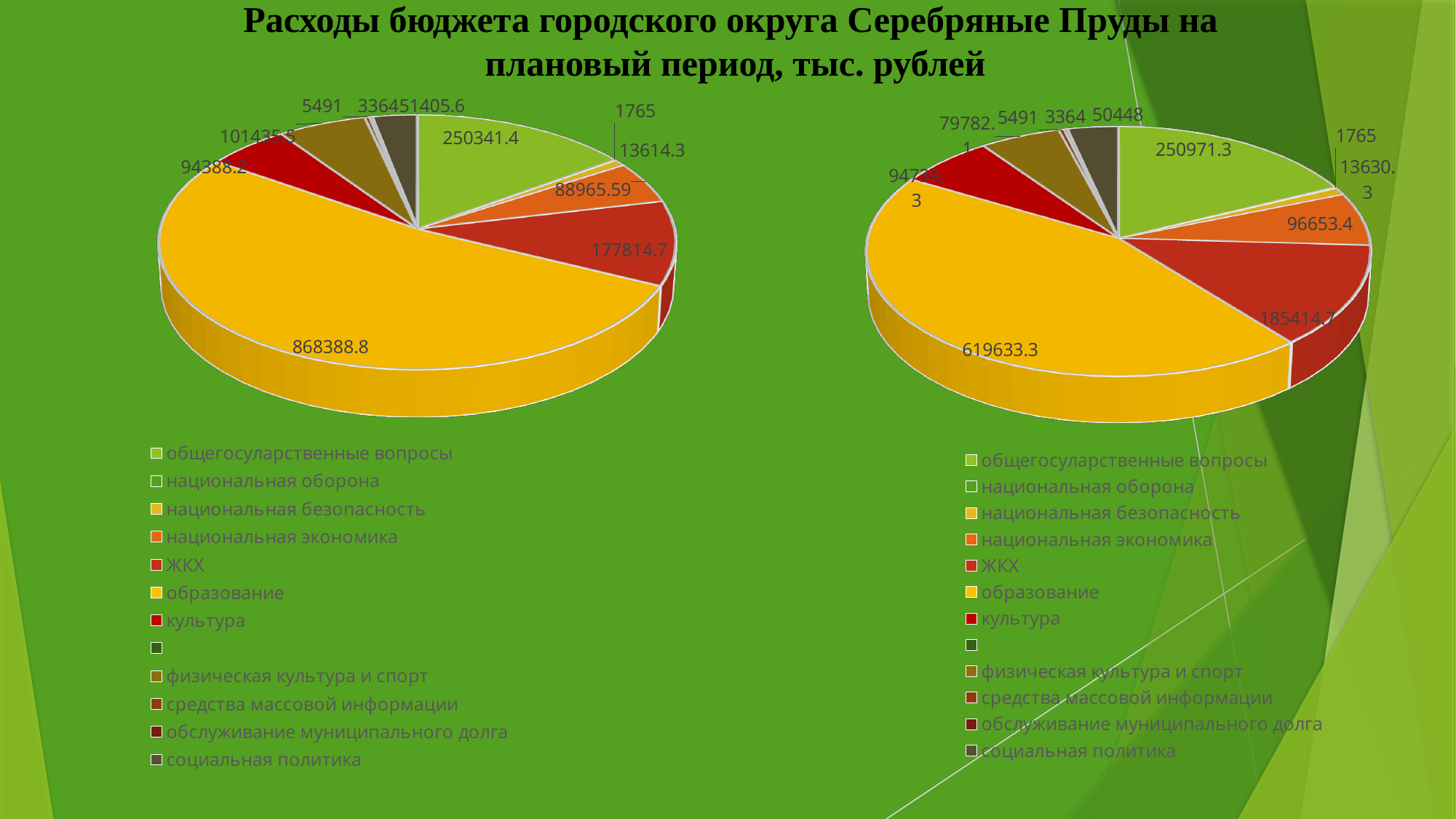
Which is larger: the value for образование in the left pie chart or in the right pie chart? left pie chart In the left pie chart, what is the value for ЖКХ? 177814.7 What is the difference between the ЖКХ value in the right pie chart (185414.7) and in the left pie chart (177814.7)? 7600 What is the title of the slide's charts? Расходы бюджета городского округа Серебряные Пруды на плановый период, тыс. рублей In the left pie chart, which category has the largest slice? образование What kind of charts are shown on the slide? pie charts In the right pie chart, what is the value for образование? 619633.3 How many pie charts are on the slide? 2 In the right pie chart, which category has the largest slice? образование In the left pie chart, what is the value for образование? 868388.8 What is the difference between the образование value in the left pie chart (868388.8) and in the right pie chart (619633.3)? 248755.5 In the right pie chart, what is the value for ЖКХ? 185414.7